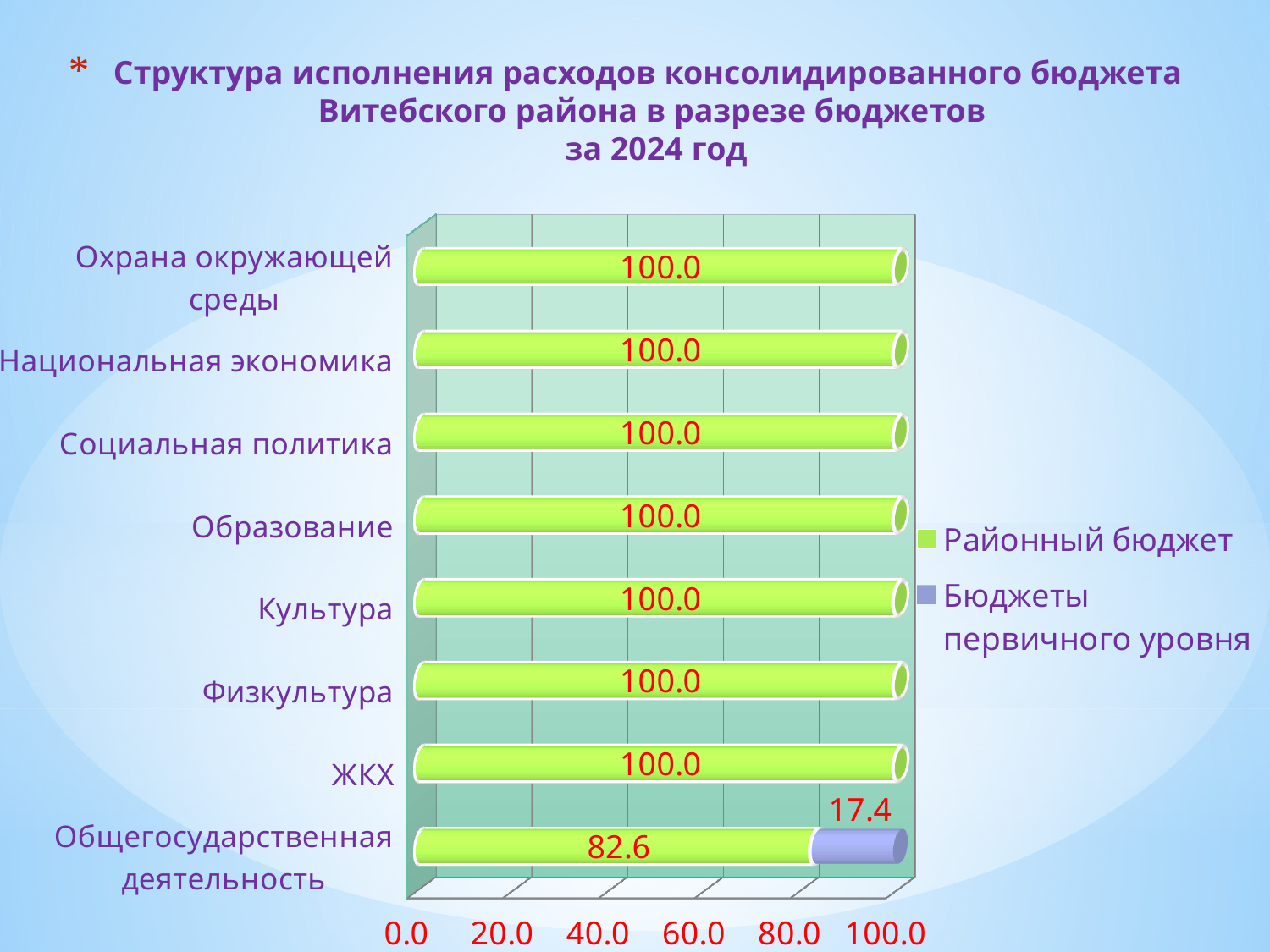
What is the value of Районный бюджет for Общегосударственная деятельность? 82.6 What is the difference between the Районный бюджет value for Культура and the Районный бюджет value for Общегосударственная деятельность? 17.4 Which series is shown in green in the legend? Районный бюджет What kind of chart is shown on the slide? bar chart How many categories are shown on the chart? 8 What is the total of the stacked bar for Общегосударственная деятельность? 100.0 What is the value of Районный бюджет for Образование? 100.0 What is the value of Районный бюджет for ЖКХ? 100.0 How many series does the legend list? 2 What is the value of Бюджеты первичного уровня for Общегосударственная деятельность? 17.4 Which is larger for Общегосударственная деятельность: Районный бюджет or Бюджеты первичного уровня? Районный бюджет Which category has the lowest value for Районный бюджет? Общегосударственная деятельность